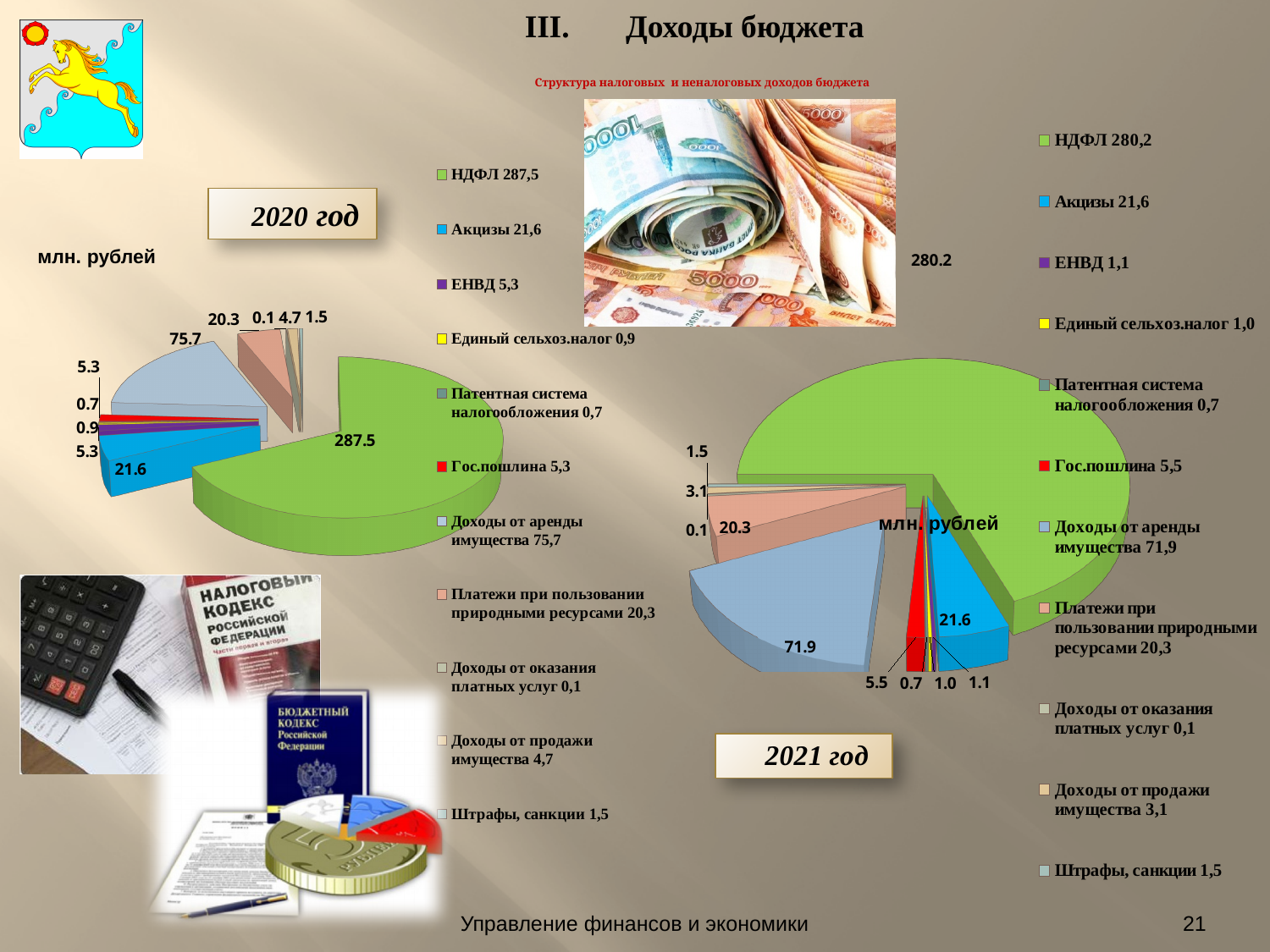
In the 2021 год chart, which is larger: Гос.пошлина or ЕНВД? Гос.пошлина In the 2020 год chart, what value is labelled on the НДФЛ slice? 287.5 In the 2020 год chart, what is the difference between Доходы от аренды имущества and Платежи при пользовании природными ресурсами? 55.4 How much larger is the НДФЛ value in the 2020 год chart than in the 2021 год chart? 7.3 In the 2021 год chart, what value is labelled on the Доходы от аренды имущества slice? 71.9 In the 2021 год chart, which category has the smallest value? Доходы от оказания платных услуг In the 2020 год chart, what value is labelled on the Акцизы slice? 21.6 In the 2020 год chart, which category has the largest slice? НДФЛ What type of chart is used for the 2020 год chart? pie chart In the 2021 год chart, what value is labelled on the Доходы от продажи имущества slice? 3.1 In the 2021 год chart, what colour is the НДФЛ slice? green How many categories does the legend of the 2020 год chart list? 11